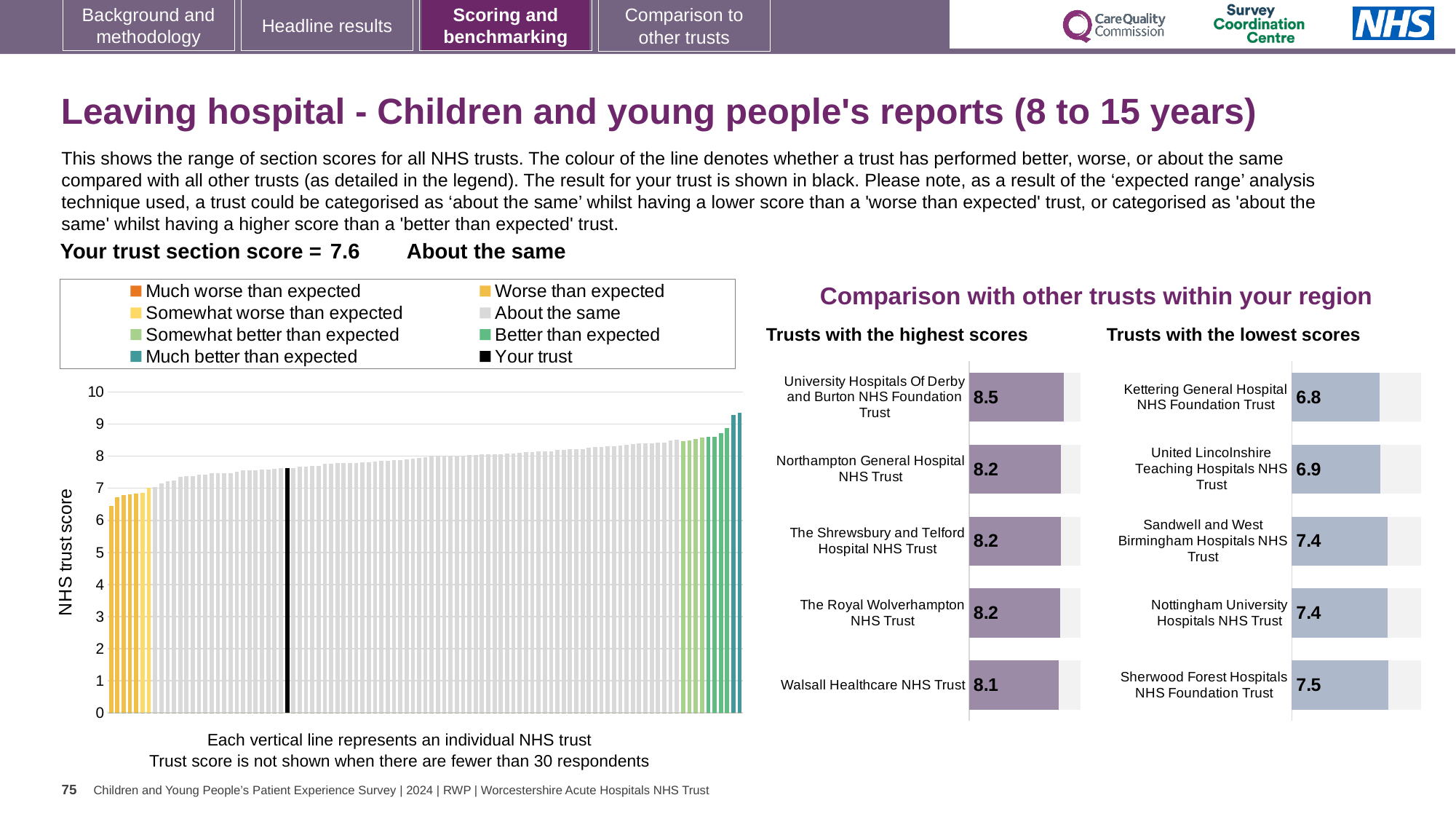
In the 'Trusts with the lowest scores' chart, which trust has the highest score? Sherwood Forest Hospitals NHS Foundation Trust In the 'Trusts with the lowest scores' chart, which has the larger score: United Lincolnshire Teaching Hospitals NHS Trust or Nottingham University Hospitals NHS Trust? Nottingham University Hospitals NHS Trust In the 'Trusts with the lowest scores' chart, what is the difference between the scores of Sherwood Forest Hospitals NHS Foundation Trust and Kettering General Hospital NHS Foundation Trust? 0.7 In the 'Trusts with the highest scores' chart, what is the difference between the scores of University Hospitals Of Derby and Burton NHS Foundation Trust and Walsall Healthcare NHS Trust? 0.4 In the 'Trusts with the highest scores' chart, what is the score for Walsall Healthcare NHS Trust? 8.1 In the NHS trust score chart on the left, is the value for the black bar (your trust) greater or less than 7? greater How many entries does the legend of the NHS trust score chart on the left list? 8 In the 'Trusts with the highest scores' chart, how many trusts are shown? 5 In the NHS trust score chart on the left, do the bar values rise or fall from left to right? rise In the 'Trusts with the lowest scores' chart, what is the score for Kettering General Hospital NHS Foundation Trust? 6.8 In the 'Trusts with the lowest scores' chart, which trust has the lowest score? Kettering General Hospital NHS Foundation Trust In the 'Trusts with the highest scores' chart, what is the score for University Hospitals Of Derby and Burton NHS Foundation Trust? 8.5